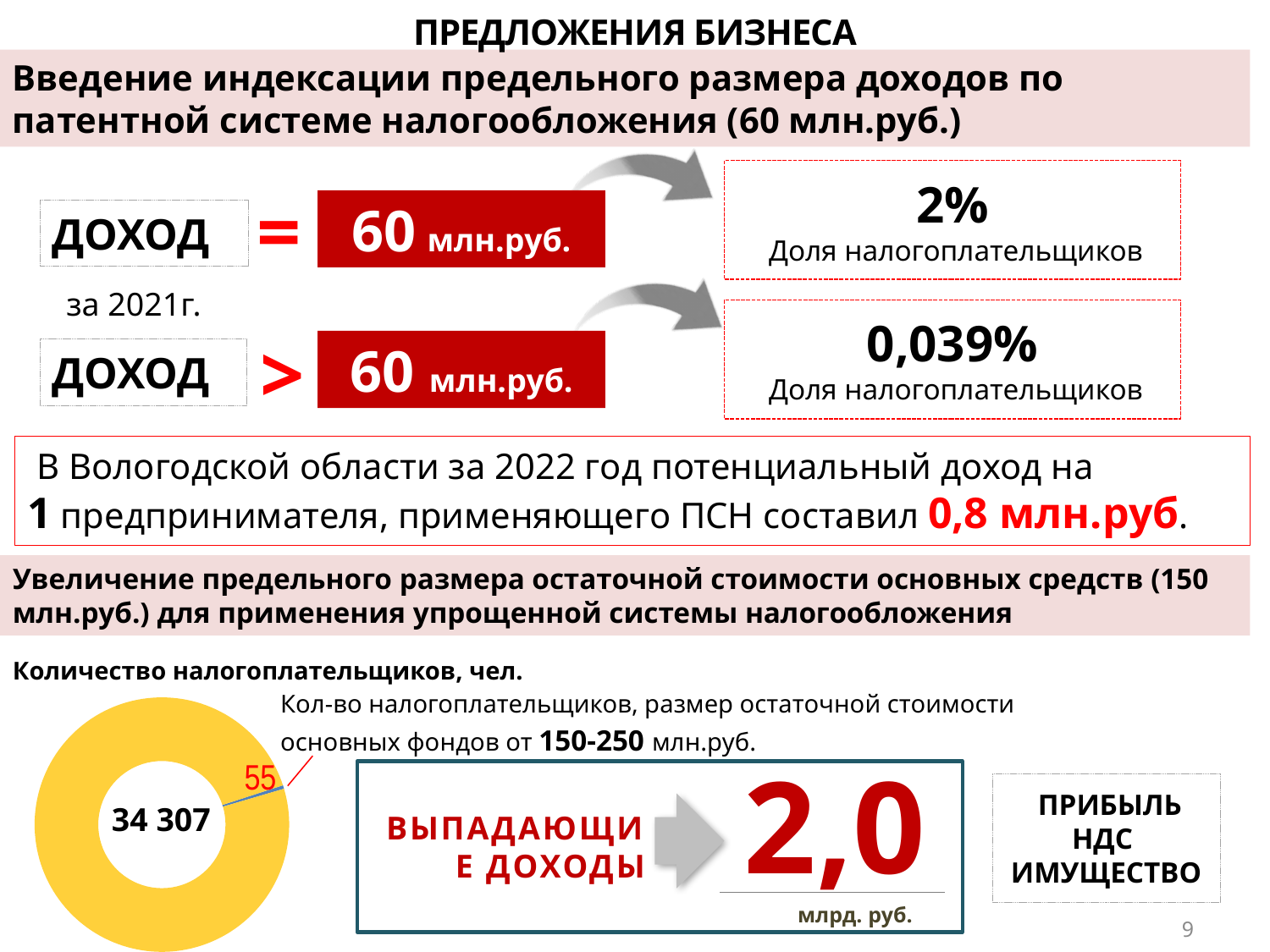
What is the difference between the two values in the doughnut chart, 34 307 and 55? 34 252 How many segments does the doughnut chart have? 2 What colour is the large segment of the doughnut chart? yellow What value is shown for the small segment of the doughnut chart (taxpayers with residual value of fixed assets from 150-250 million rubles)? 55 What is the title of the doughnut chart on the slide? Количество налогоплательщиков, чел. What is the total of the two values shown in the doughnut chart? 34 362 What value is printed inside the large yellow segment of the doughnut chart? 34 307 What kind of chart is shown at the bottom left of the slide? doughnut chart Which segment of the doughnut chart is the largest? 34 307 Which segment of the doughnut chart is the smallest? 55 In the doughnut chart, which is larger: the segment labelled 34 307 or the segment labelled 55? 34 307